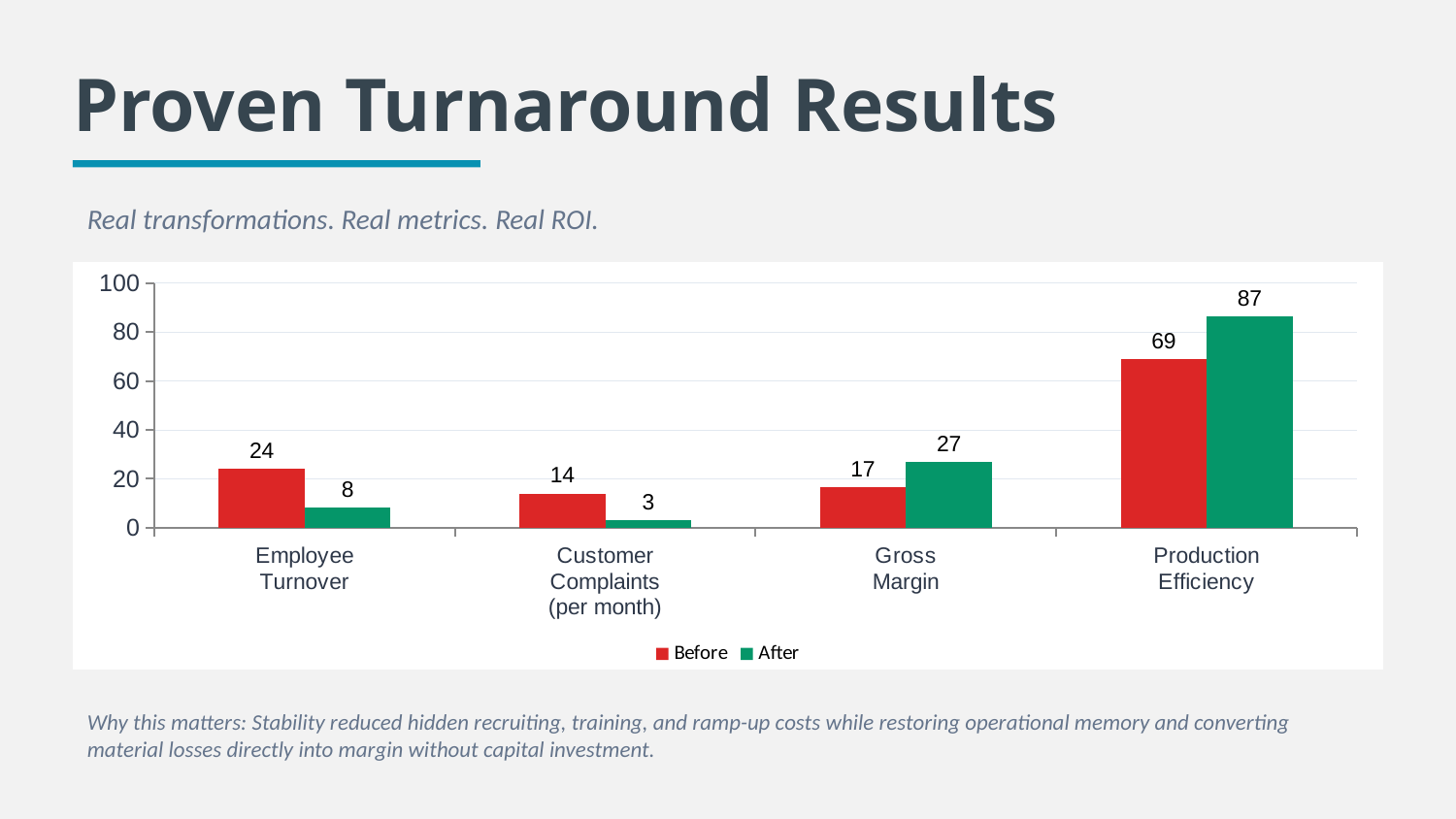
Which colour represents the After series in the legend? Green What is the Before value for Gross Margin? 17 What is the difference between the After and Before values for Production Efficiency? 18 Which category has the lowest Before value? Customer Complaints (per month) Which is larger for Gross Margin, the Before value or the After value? After What kind of chart is shown on the slide? Bar chart What is the Before value for Employee Turnover? 24 What is the After value for Production Efficiency? 87 Which category has the highest After value? Production Efficiency How many categories are shown on the x axis? 4 What is the After value for Customer Complaints (per month)? 3 How many series does the legend list? 2